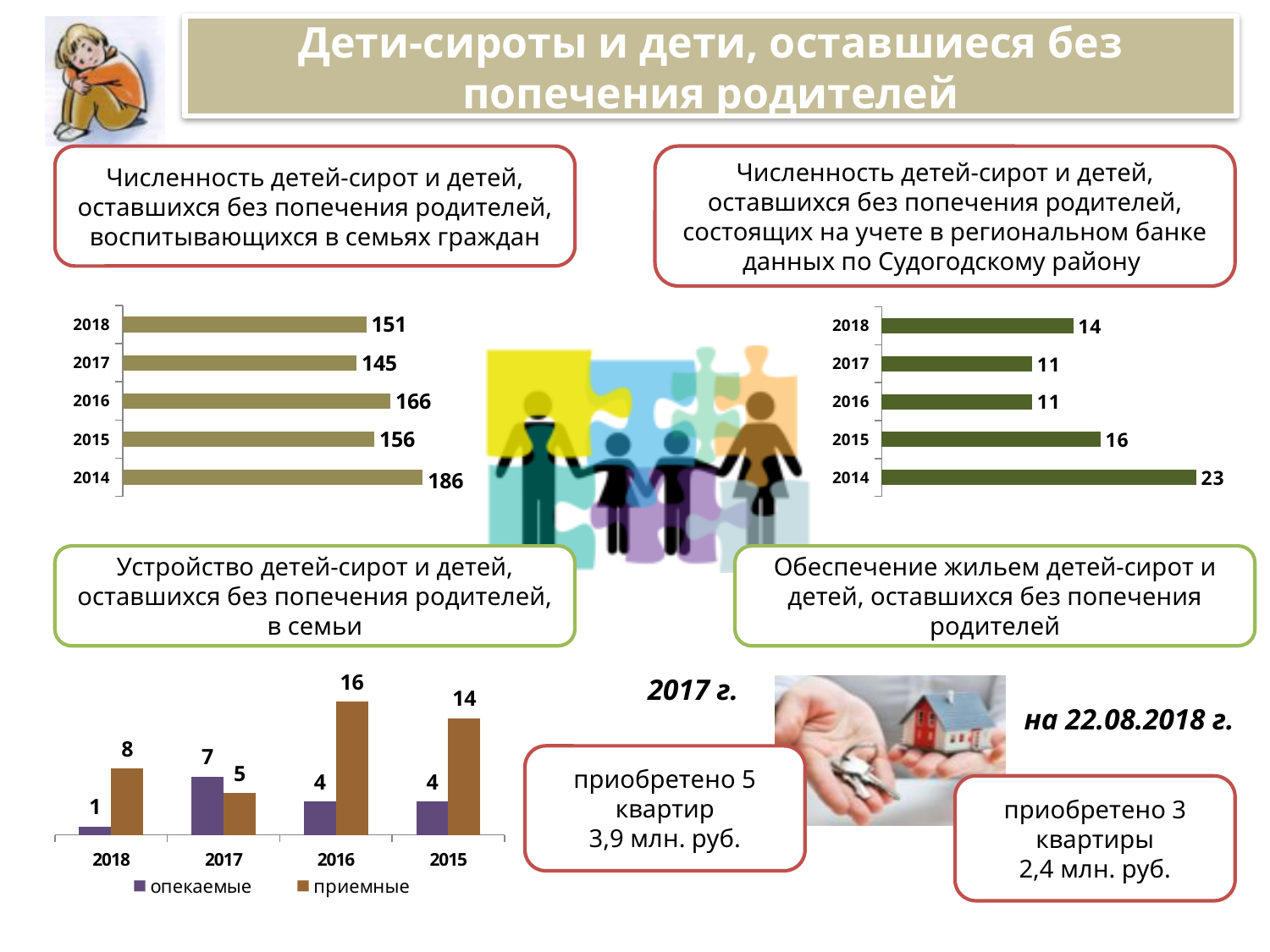
In the top-left chart (children raised in families of citizens), how many years are shown? 5 In the bottom-left chart (placement of children in families), what is the value for опекаемые in 2018? 1 What type of chart is the top-right chart (children registered in the regional data bank)? bar chart In the top-right chart (children registered in the regional data bank), which year has the lowest value? 2016 and 2017 In the bottom-left chart (placement of children in families), what is the difference between приемные and опекаемые in 2015? 10 In the top-right chart (children registered in the regional data bank), what is the value for 2014? 23 In the top-right chart (children registered in the regional data bank), is the value for 2015 larger or smaller than the value for 2018? larger In the bottom-left chart (placement of children in families), what is the value for приемные in 2016? 16 In the top-left chart (children raised in families of citizens), which year has the highest value? 2014 In the top-left chart (children raised in families of citizens), what is the value for 2018? 151 In the bottom-left chart (placement of children in families), how many series does the legend list? 2 In the top-left chart (children raised in families of citizens), what is the difference between the values for 2016 and 2017? 21